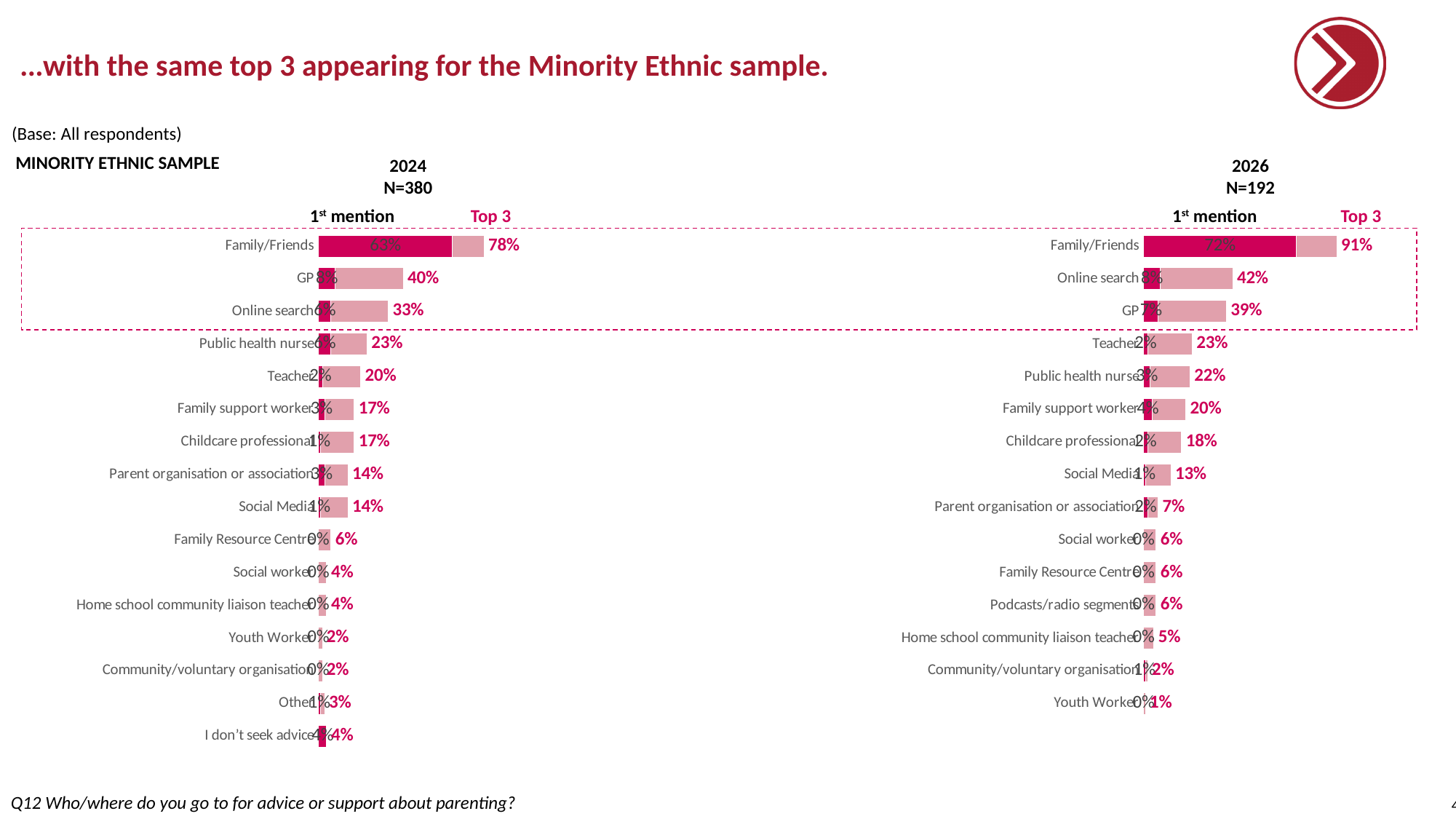
In the 2024 chart, what is the Top 3 value for GP? 40% How many categories are shown in the 2026 chart? 15 What is the difference between the Top 3 value for Family/Friends in the 2026 chart and in the 2024 chart? 13% In the 2026 chart, what is the 1st mention value for Family/Friends? 72% In the 2024 chart, which has a larger Top 3 value: GP or Online search? GP In the 2026 chart, which category has the lowest Top 3 value? Youth Worker What type of chart is used on this slide? Bar chart In the 2026 chart, what is the Top 3 value for Online search? 42% In the 2026 chart, which category has the highest Top 3 value? Family/Friends In the 2024 chart, what is the 1st mention value for Family/Friends? 63% In the 2026 chart, what is the Top 3 value for Family/Friends? 91% In the 2024 chart, what is the Top 3 value for Family/Friends? 78%